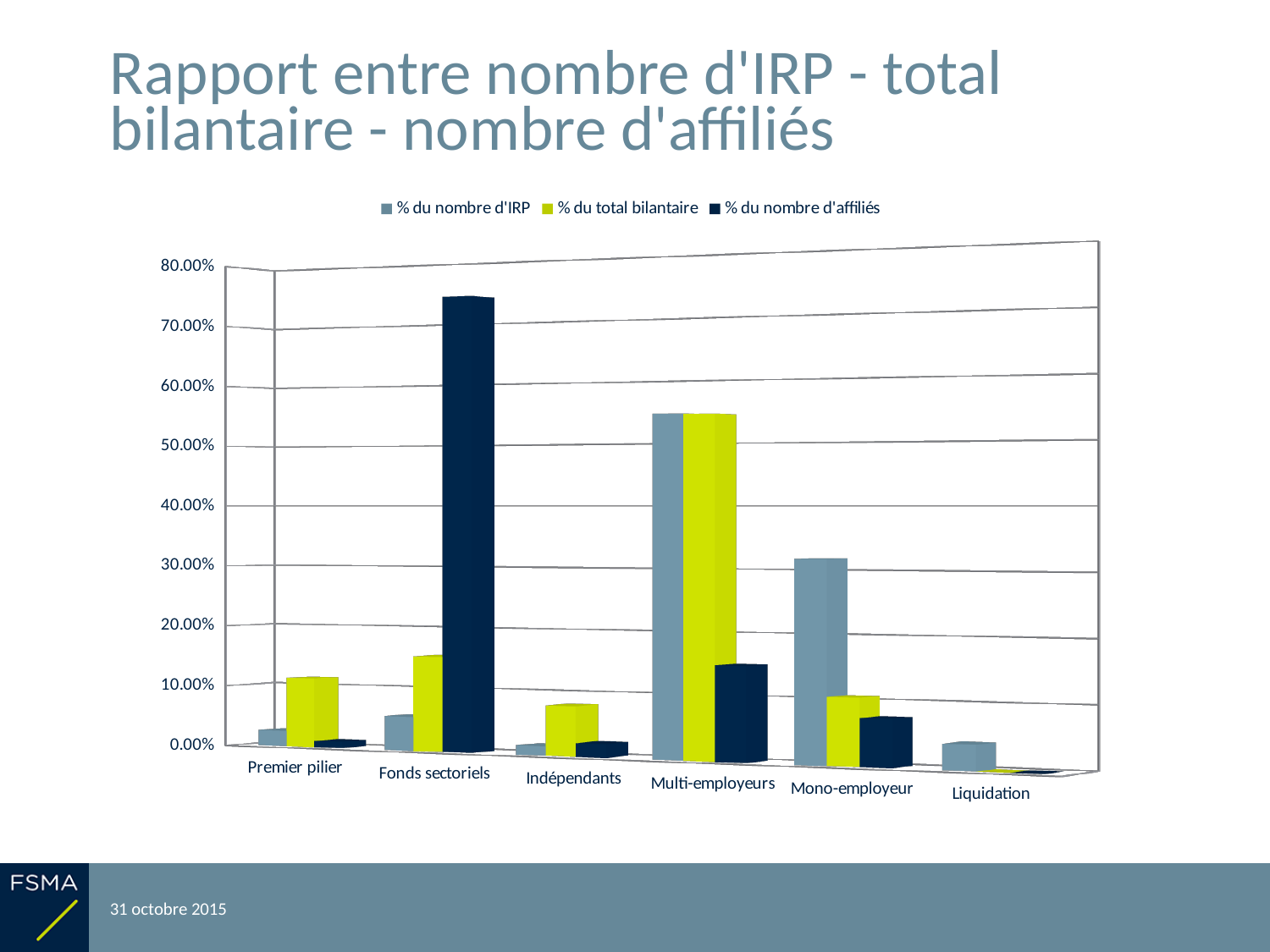
Which is larger for '% du nombre d'affiliés': Fonds sectoriels or Multi-employeurs? Fonds sectoriels Which category has the highest value for '% du total bilantaire'? Multi-employeurs Is the value of '% du nombre d'IRP' for Mono-employeur greater or less than 20.00%? greater How many series does the legend list? 3 Which category has the highest value for '% du nombre d'affiliés'? Fonds sectoriels Is the value of '% du nombre d'affiliés' for Fonds sectoriels greater or less than 60.00%? greater How many categories are shown on the x axis? 6 Which category has the highest value for '% du nombre d'IRP'? Multi-employeurs What colour represents '% du nombre d'affiliés' in the legend? dark navy blue Is the value of '% du nombre d'IRP' for Multi-employeurs greater or less than 40.00%? greater What kind of chart is shown on the slide? bar chart For Premier pilier, which series has the larger value: '% du nombre d'IRP' or '% du total bilantaire'? % du total bilantaire